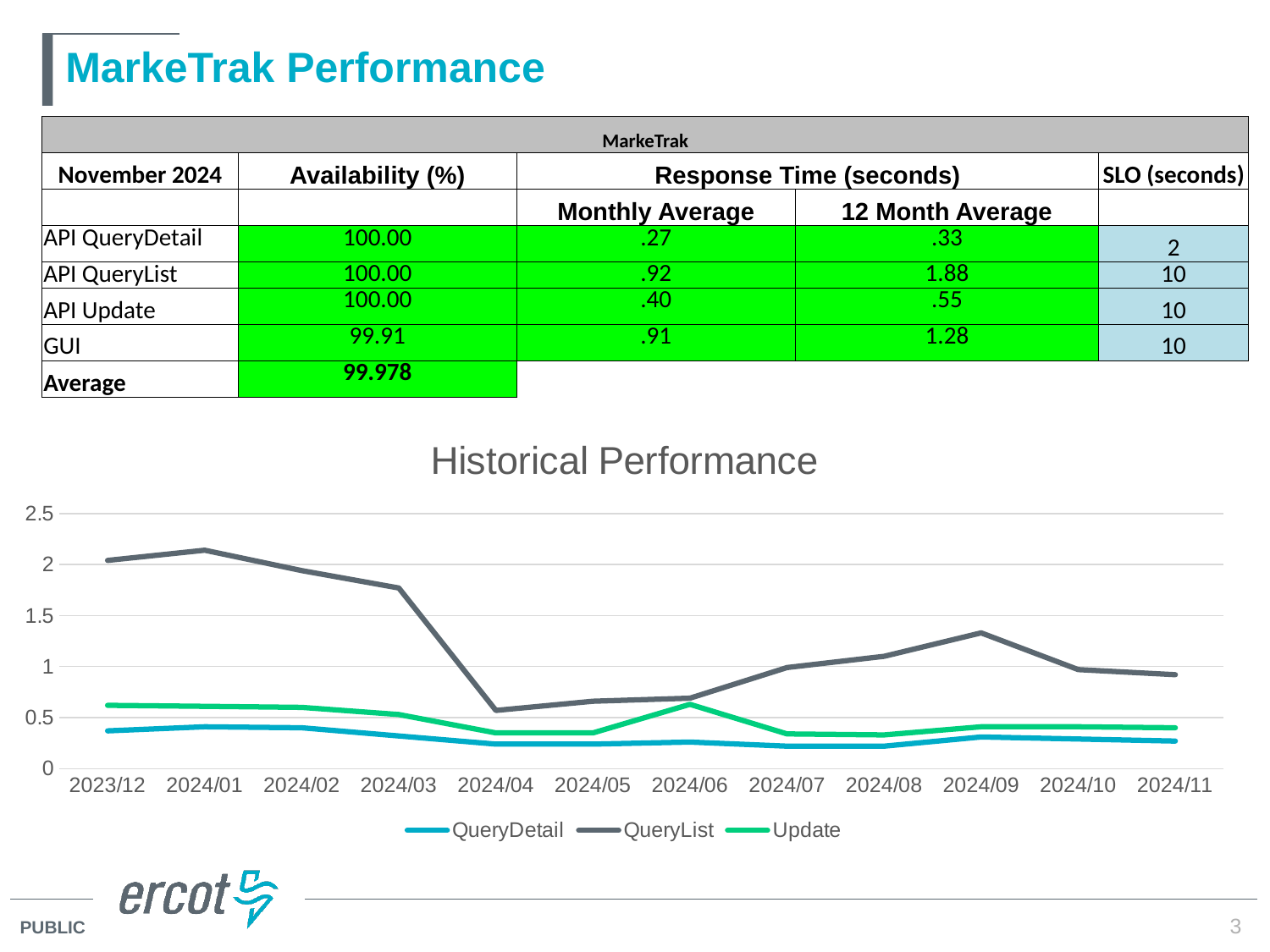
In the Historical Performance chart, is the QueryDetail value for 2024/08 greater or less than 0.5? less In the Historical Performance chart, which series has the higher value at 2024/06, Update or QueryDetail? Update How many months are plotted along the x axis of the Historical Performance chart? 12 In the Historical Performance chart, is the QueryList value for 2024/04 greater or less than 1? less In the Historical Performance chart, is the QueryList value for 2024/03 greater or less than 1.5? greater In the Historical Performance chart, which series has the higher value at 2024/09, QueryList or QueryDetail? QueryList What kind of chart is the Historical Performance chart? line chart In the Historical Performance chart, in which month does the QueryList series reach its lowest value? 2024/04 In the Historical Performance chart, does the QueryList series rise or fall from 2024/01 to 2024/04? fall How many series does the legend of the Historical Performance chart list? 3 In the Historical Performance chart, in which month does the QueryList series reach its highest value? 2024/01